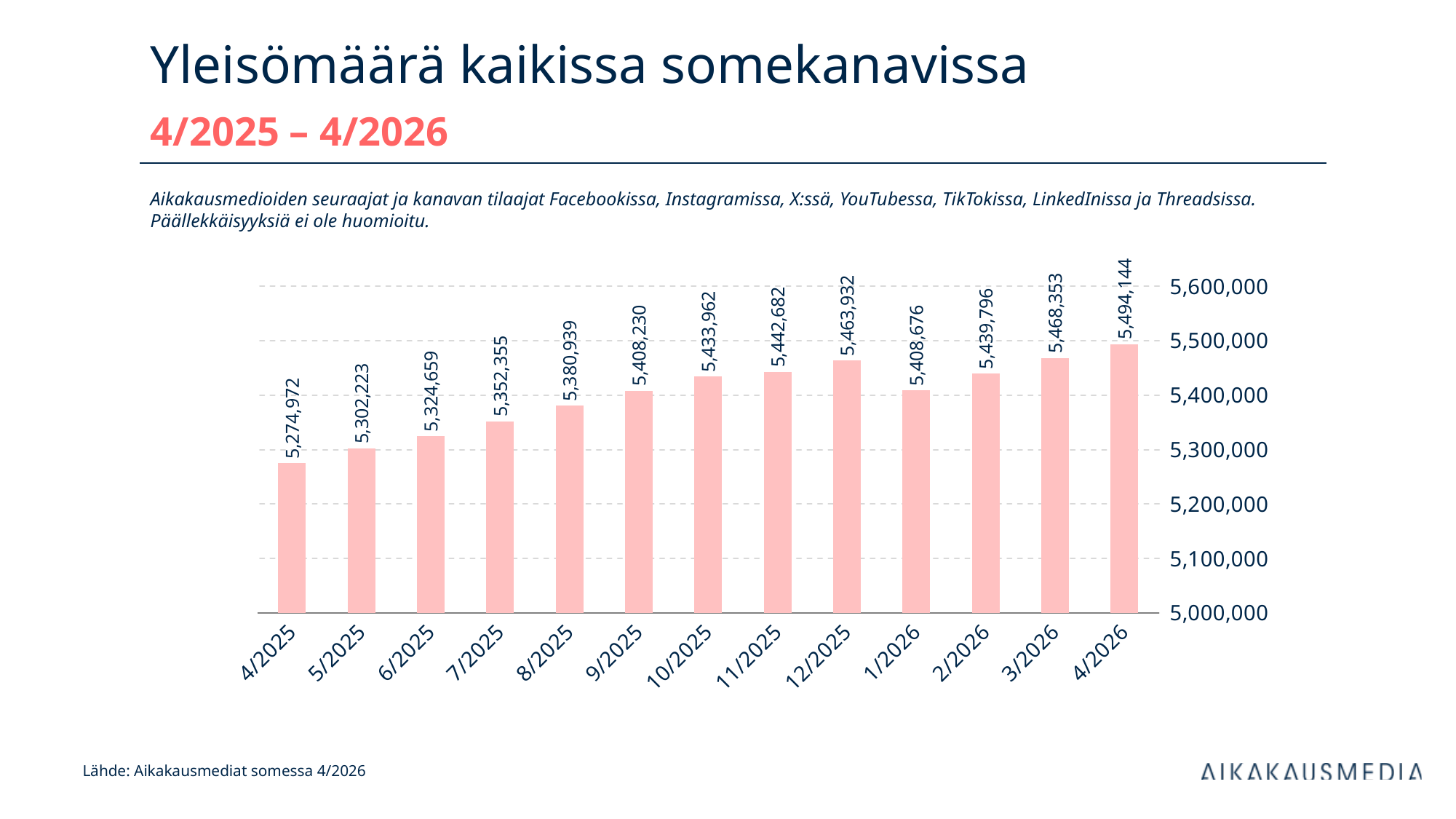
What is the value for 1/2026? 5,408,676 What kind of chart is shown on the slide? bar chart What is the value for 4/2025? 5,274,972 What is the value for 12/2025? 5,463,932 Which month has the lowest value? 4/2025 What is the difference between the values for 12/2025 and 1/2026? 55,256 Is the value for 8/2025 greater or less than 5,400,000? less Which month has the highest value? 4/2026 How many months are shown on the x axis? 13 Which is larger, the value for 12/2025 or the value for 1/2026? 12/2025 What is the difference between the values for 4/2026 and 4/2025? 219,172 What is the value for 4/2026? 5,494,144